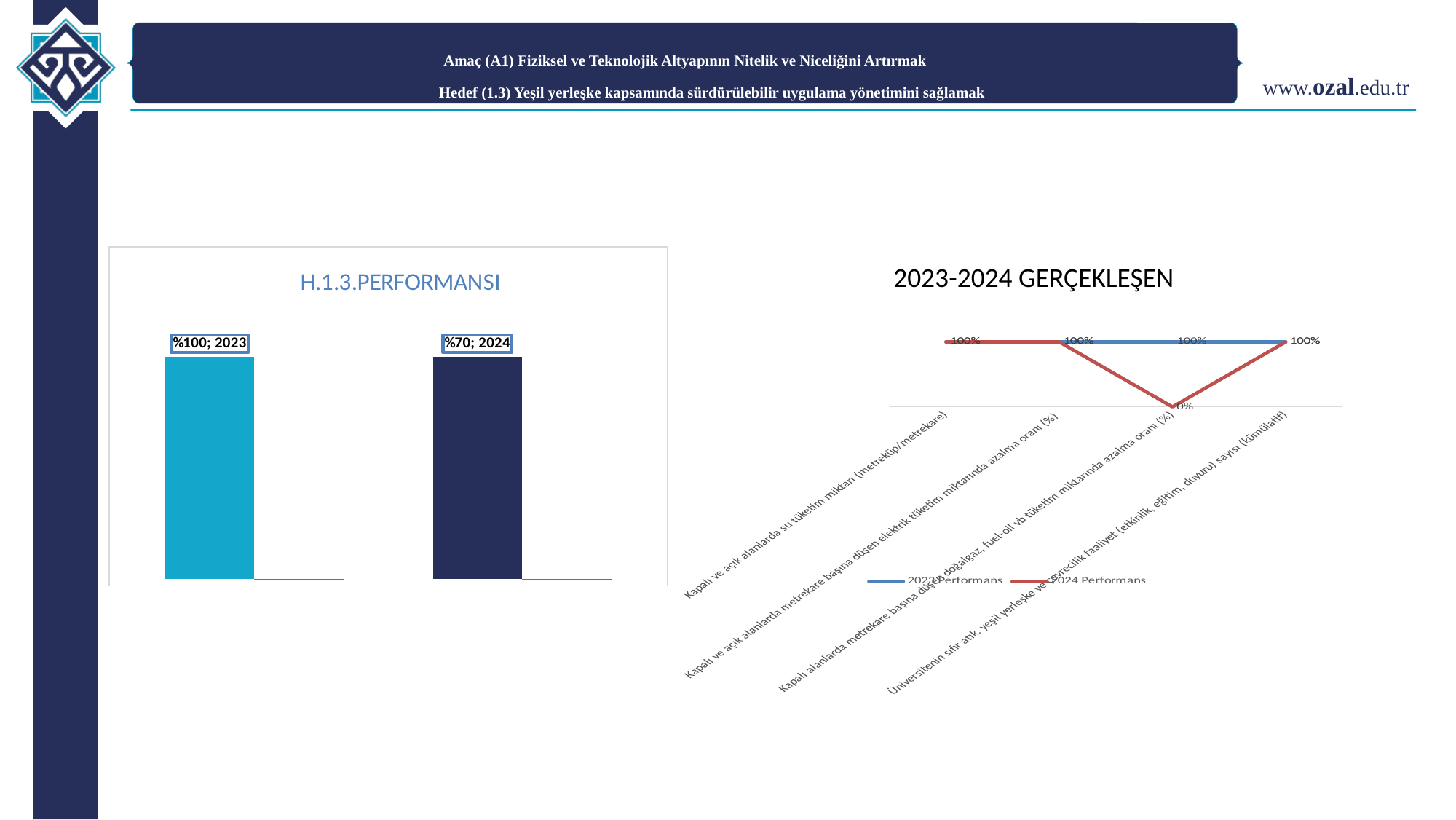
What kind of chart is the 2023-2024 GERÇEKLEŞEN chart? line chart On the H.1.3.PERFORMANSI chart, what is the difference between the 2023 and 2024 values? %30 On the 2023-2024 GERÇEKLEŞEN chart, which series is drawn in red? 2024 Performans How many bars are shown on the H.1.3.PERFORMANSI chart? 2 On the 2023-2024 GERÇEKLEŞEN chart, what is the 2024 Performans value for 'Kapalı alanlarda metrekare başına düşen doğalgaz, fuel-oil vb tüketim miktarında azalma oranı (%)'? 0% How many series does the legend of the 2023-2024 GERÇEKLEŞEN chart list? 2 On the H.1.3.PERFORMANSI chart, which year has the higher value? 2023 On the H.1.3.PERFORMANSI chart, which year has the lower value? 2024 On the H.1.3.PERFORMANSI chart, do the values rise or fall from 2023 to 2024? fall What kind of chart is the H.1.3.PERFORMANSI chart? bar chart On the H.1.3.PERFORMANSI chart, what is the value for 2023? %100 On the H.1.3.PERFORMANSI chart, what is the value for 2024? %70